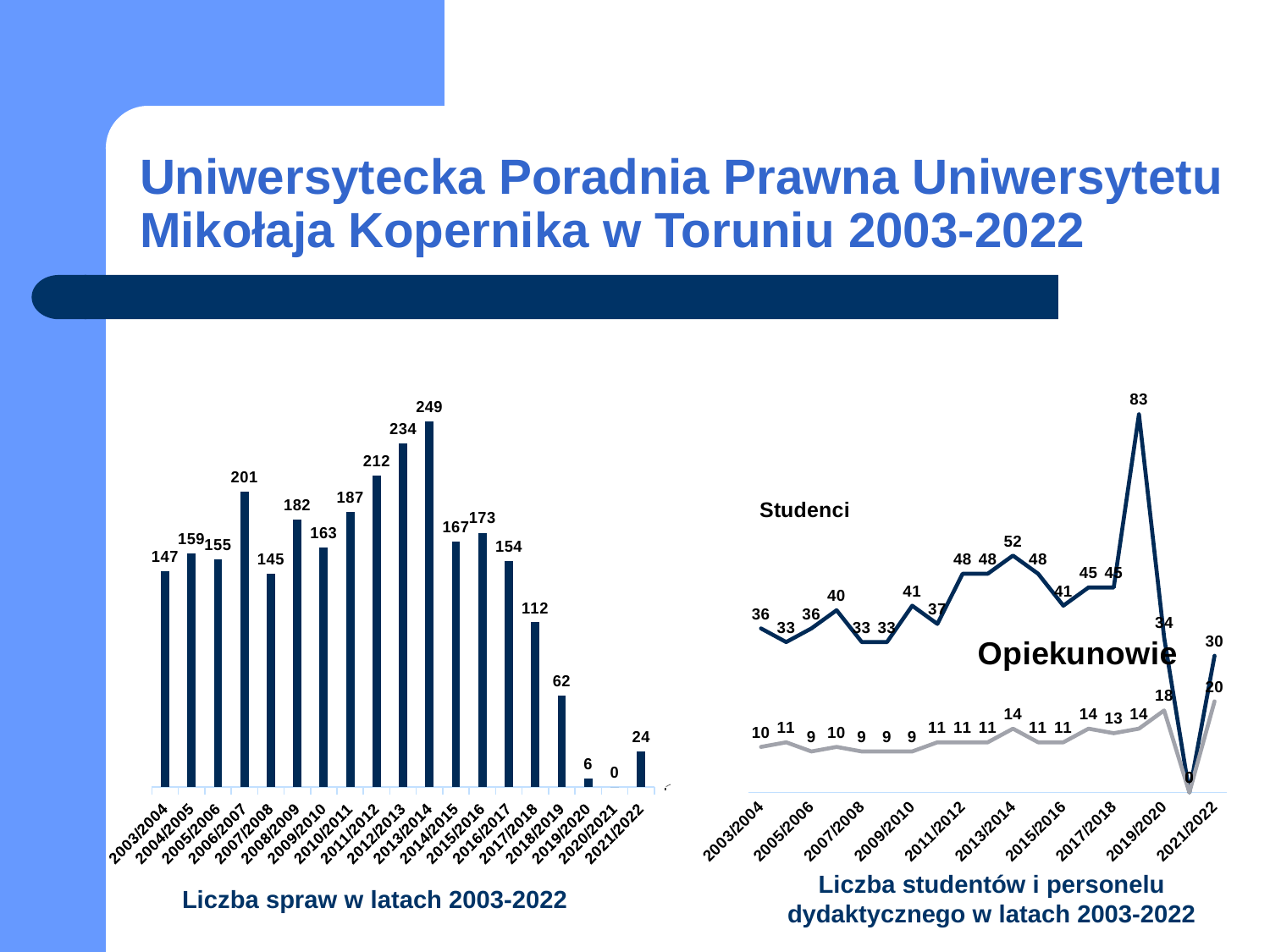
In the chart 'Liczba studentów i personelu dydaktycznego w latach 2003-2022', what is the value of Opiekunowie for 2021/2022? 20 What kind of chart is 'Liczba spraw w latach 2003-2022'? bar chart In the chart 'Liczba studentów i personelu dydaktycznego w latach 2003-2022', what is the highest value of the Studenci series? 83 In the chart 'Liczba spraw w latach 2003-2022', which year has the highest number of cases? 2013/2014 In the chart 'Liczba spraw w latach 2003-2022', which is larger, the value for 2006/2007 or for 2008/2009? 2006/2007 What kind of chart is 'Liczba studentów i personelu dydaktycznego w latach 2003-2022'? line chart In the chart 'Liczba spraw w latach 2003-2022', what is the difference between the values for 2013/2014 and 2012/2013? 15 In the chart 'Liczba spraw w latach 2003-2022', do the values rise or fall from 2013/2014 to 2020/2021? fall In the chart 'Liczba spraw w latach 2003-2022', what is the value for 2013/2014? 249 In the chart 'Liczba spraw w latach 2003-2022', which year has the lowest value? 2020/2021 How many bars (years) are shown in the chart 'Liczba spraw w latach 2003-2022'? 19 How many series are plotted in the chart 'Liczba studentów i personelu dydaktycznego w latach 2003-2022'? 2